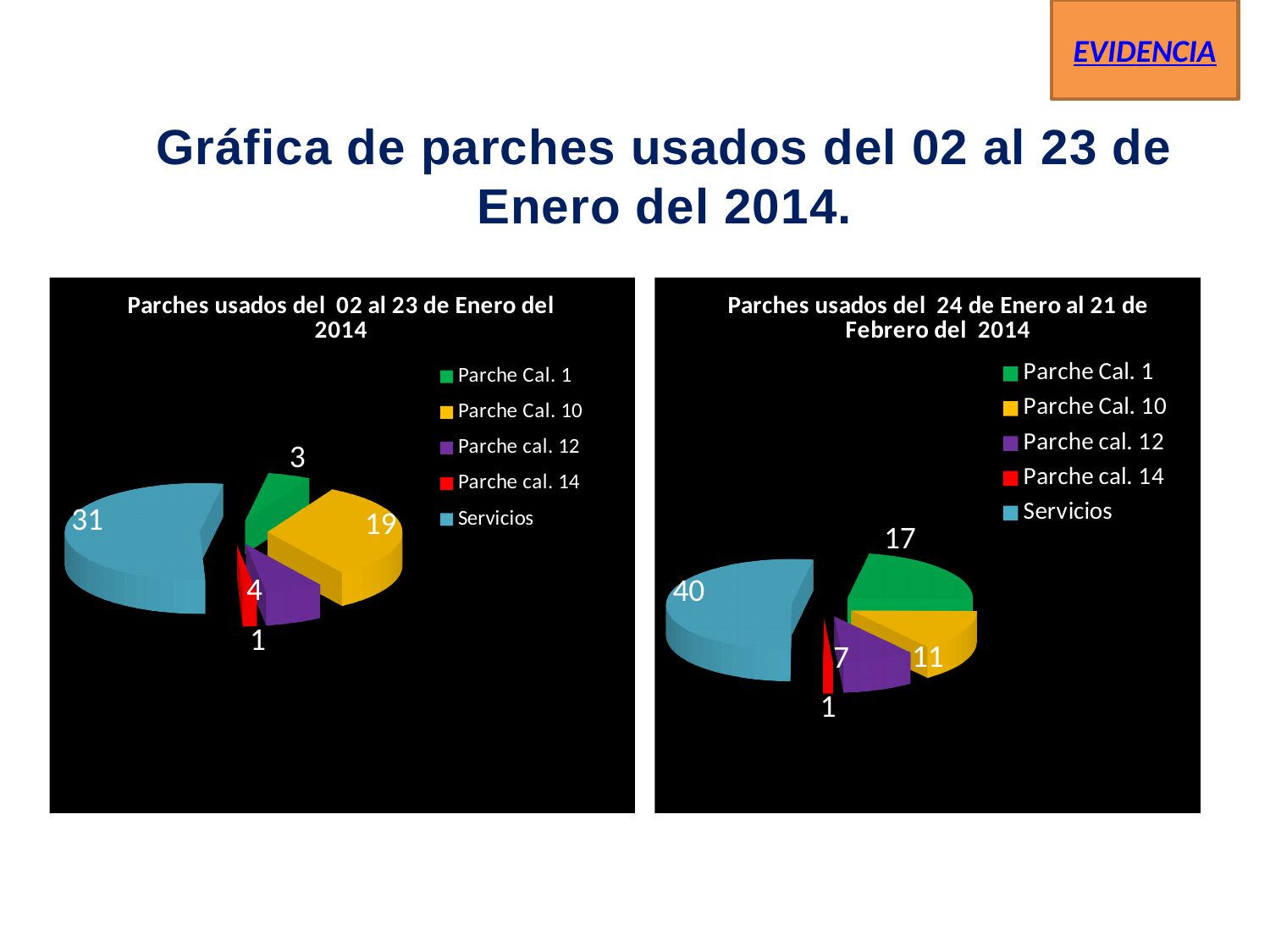
In the left chart (Parches usados del 02 al 23 de Enero del 2014), what is the value for Parche Cal. 10? 19 In the left chart (Parches usados del 02 al 23 de Enero del 2014), what is the difference between the values for Servicios and Parche Cal. 10? 12 In the left chart (Parches usados del 02 al 23 de Enero del 2014), what colour is the Servicios slice? Blue How many categories does the legend of the left chart (Parches usados del 02 al 23 de Enero del 2014) list? 5 In the left chart (Parches usados del 02 al 23 de Enero del 2014), which category has the largest slice? Servicios In the left chart (Parches usados del 02 al 23 de Enero del 2014), what is the value for Servicios? 31 In the right chart (Parches usados del 24 de Enero al 21 de Febrero del 2014), which is larger: Parche Cal. 10 or Parche cal. 12? Parche Cal. 10 In the right chart (Parches usados del 24 de Enero al 21 de Febrero del 2014), what is the difference between the values for Parche Cal. 1 and Parche Cal. 10? 6 In the right chart (Parches usados del 24 de Enero al 21 de Febrero del 2014), what is the value for Parche cal. 12? 7 What kind of chart is the right chart (Parches usados del 24 de Enero al 21 de Febrero del 2014)? Pie chart In the right chart (Parches usados del 24 de Enero al 21 de Febrero del 2014), which category has the smallest slice? Parche cal. 14 In the right chart (Parches usados del 24 de Enero al 21 de Febrero del 2014), what is the value for Parche Cal. 1? 17